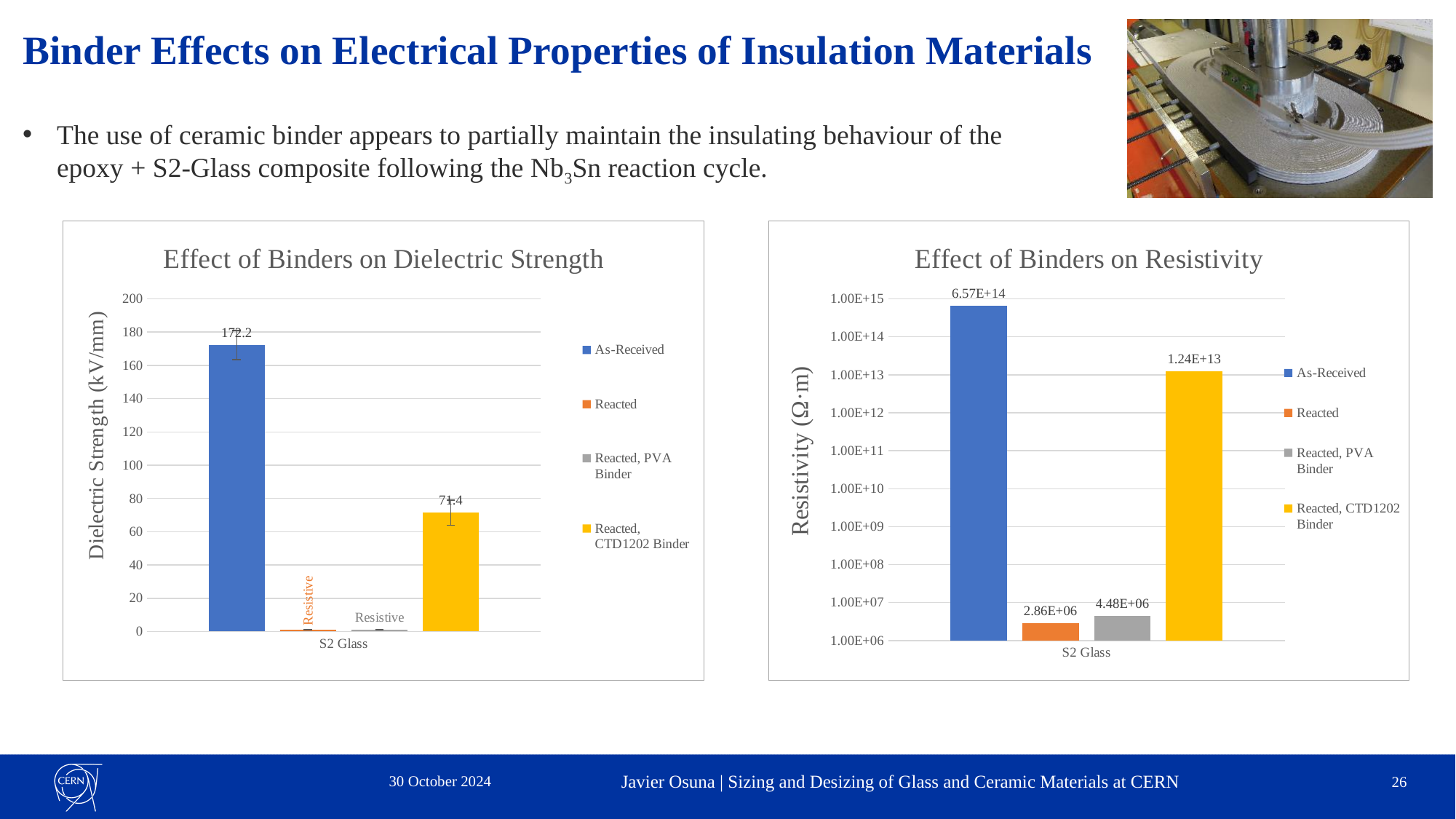
In the 'Effect of Binders on Dielectric Strength' chart, how many series does the legend list? 4 In the 'Effect of Binders on Dielectric Strength' chart, what label is shown on the Reacted and Reacted, PVA Binder bars instead of a numeric value? Resistive In the 'Effect of Binders on Resistivity' chart, what is the resistivity of the Reacted sample? 2.86E+06 In the 'Effect of Binders on Resistivity' chart, what is the resistivity of the Reacted, CTD1202 Binder sample? 1.24E+13 In the 'Effect of Binders on Dielectric Strength' chart, what is the dielectric strength of the As-Received sample? 172.2 In the 'Effect of Binders on Dielectric Strength' chart, which series has the highest dielectric strength? As-Received In the 'Effect of Binders on Dielectric Strength' chart, what is the difference between the As-Received value and the Reacted, CTD1202 Binder value? 100.8 What type of chart is 'Effect of Binders on Resistivity'? Bar chart In the 'Effect of Binders on Resistivity' chart, what is the resistivity of the As-Received sample? 6.57E+14 In the 'Effect of Binders on Resistivity' chart, which series has the lowest resistivity? Reacted In the 'Effect of Binders on Dielectric Strength' chart, what is the value for the Reacted, CTD1202 Binder series? 71.4 In the 'Effect of Binders on Resistivity' chart, what is the resistivity of the Reacted, PVA Binder sample? 4.48E+06